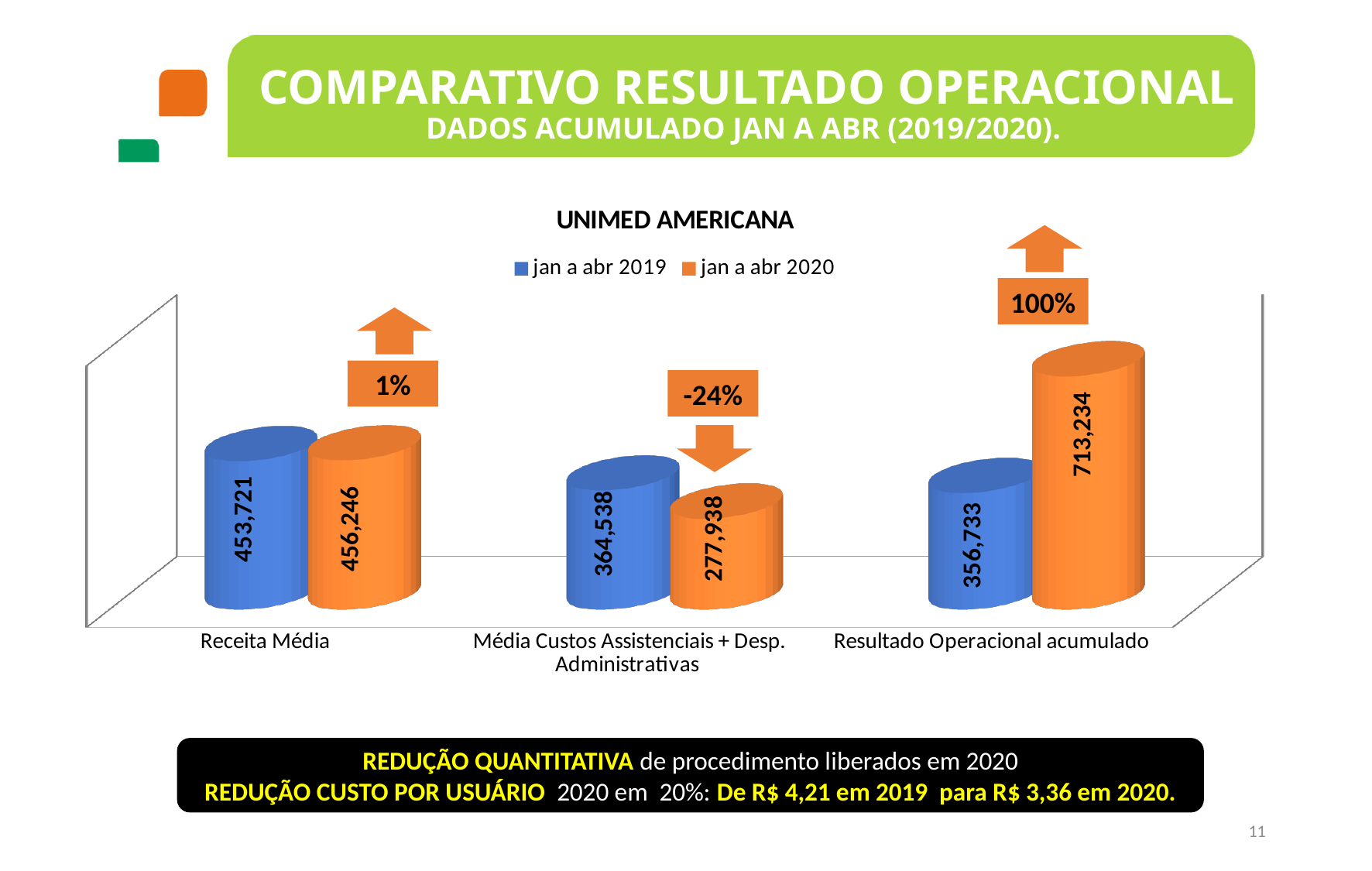
What is the difference between the jan a abr 2020 and jan a abr 2019 values for Resultado Operacional acumulado? 356,501 What is the difference between the jan a abr 2019 and jan a abr 2020 values for Média Custos Assistenciais + Desp. Administrativas? 86,600 For Média Custos Assistenciais + Desp. Administrativas, which series has the larger value, jan a abr 2019 or jan a abr 2020? jan a abr 2019 What is the value for Resultado Operacional acumulado in the jan a abr 2020 series? 713,234 How many categories are shown on the x axis of the chart? 3 How many series does the chart legend list? 2 What is the value for Receita Média in the jan a abr 2019 series? 453,721 Which category has the highest value in the jan a abr 2020 series? Resultado Operacional acumulado What percentage change is shown above the Resultado Operacional acumulado bars? 100% What is the value for Média Custos Assistenciais + Desp. Administrativas in the jan a abr 2020 series? 277,938 Which category has the lowest value in the jan a abr 2020 series? Média Custos Assistenciais + Desp. Administrativas Which category has the highest value in the jan a abr 2019 series? Receita Média